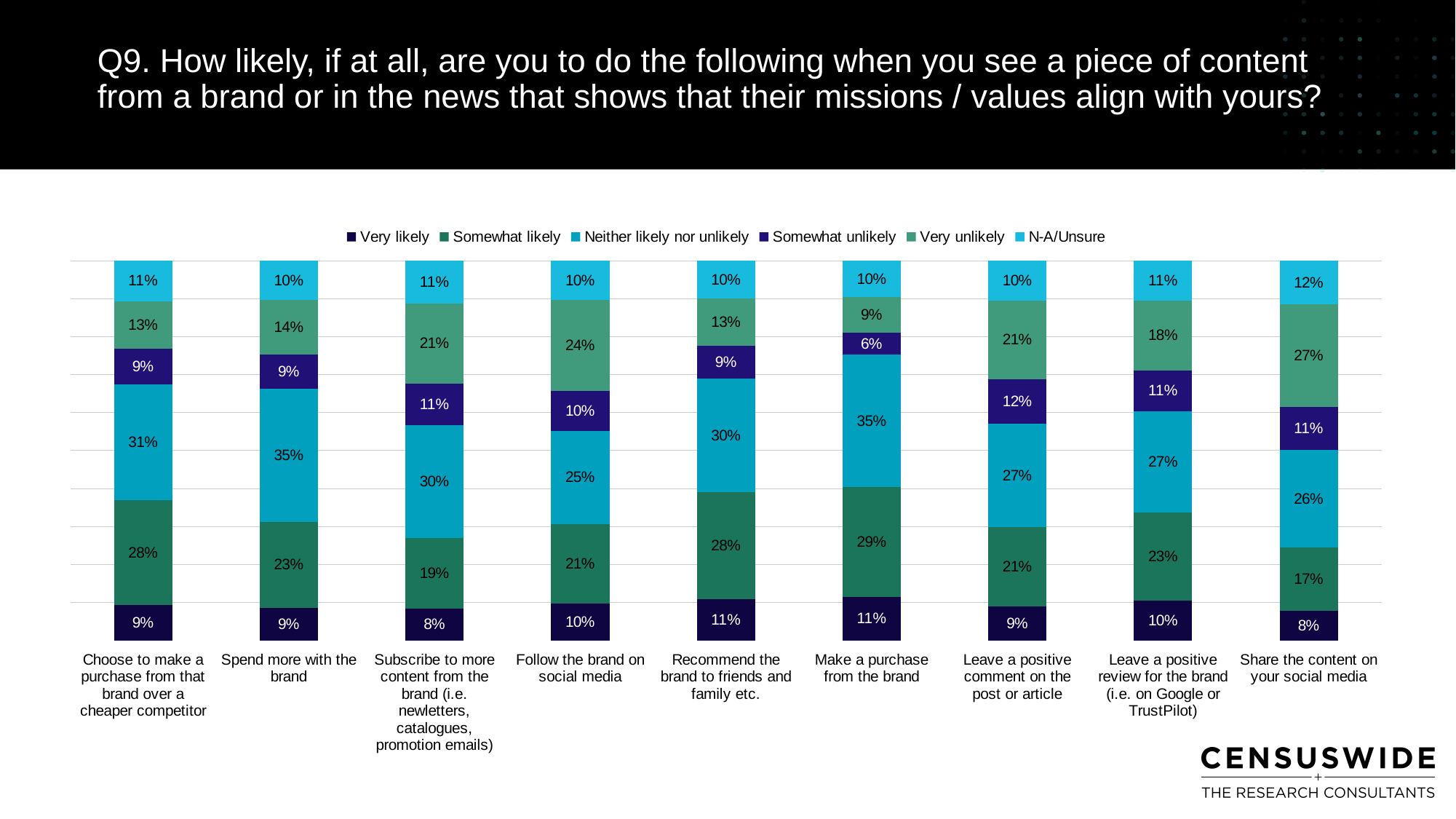
What is the difference between the 'Somewhat likely' values for 'Choose to make a purchase from that brand over a cheaper competitor' and 'Share the content on your social media'? 11 percentage points What is the total of the stacked bar for 'Spend more with the brand'? 100% What is the first entry in the chart's legend? Very likely Which has the larger 'Somewhat likely' value: 'Spend more with the brand' or 'Recommend the brand to friends and family etc.'? Recommend the brand to friends and family etc. How many series does the legend list? 6 Which category has the highest 'Very unlikely' value? Share the content on your social media What is the 'N-A/Unsure' value for 'Share the content on your social media'? 12% How many categories (actions) are plotted along the x axis? 9 What is the 'Very likely' value for 'Make a purchase from the brand'? 11% What kind of chart is shown on the slide? Stacked bar chart Which category has the lowest 'Somewhat unlikely' value? Make a purchase from the brand What is the 'Very unlikely' value for 'Share the content on your social media'? 27%